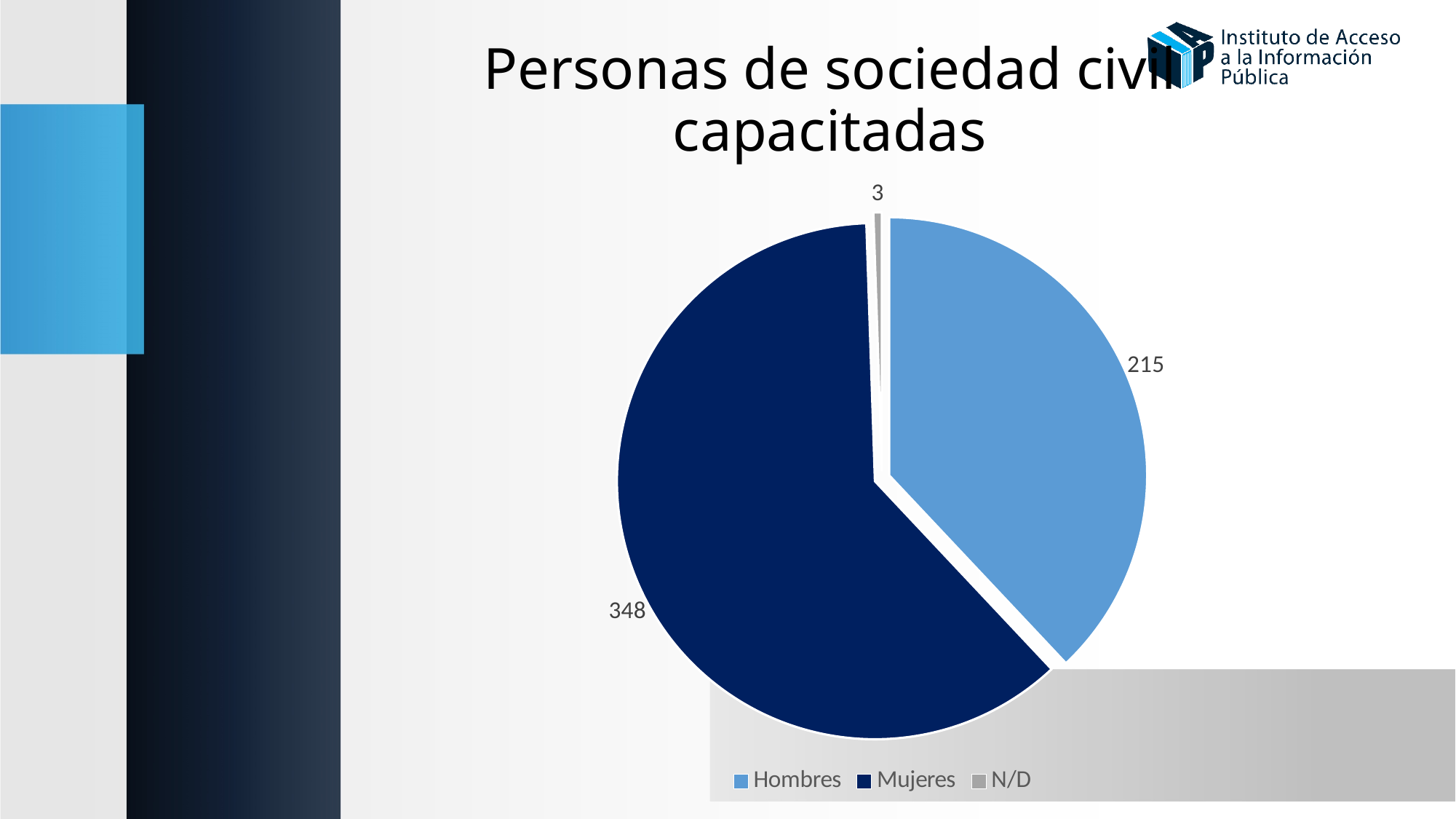
Which category has the smallest slice? N/D What is the value for N/D? 3 What is the total of all slices in the pie chart? 566 Which is larger, the value for Hombres or the value for Mujeres? Mujeres How many entries does the legend list? 3 What is the value for Mujeres? 348 What kind of chart is shown on the slide? Pie chart How many slices does the pie chart have? 3 What is the value for Hombres? 215 What is the difference between the values for Mujeres and Hombres? 133 Which category has the largest slice? Mujeres What is the title of the chart? Personas de sociedad civil capacitadas